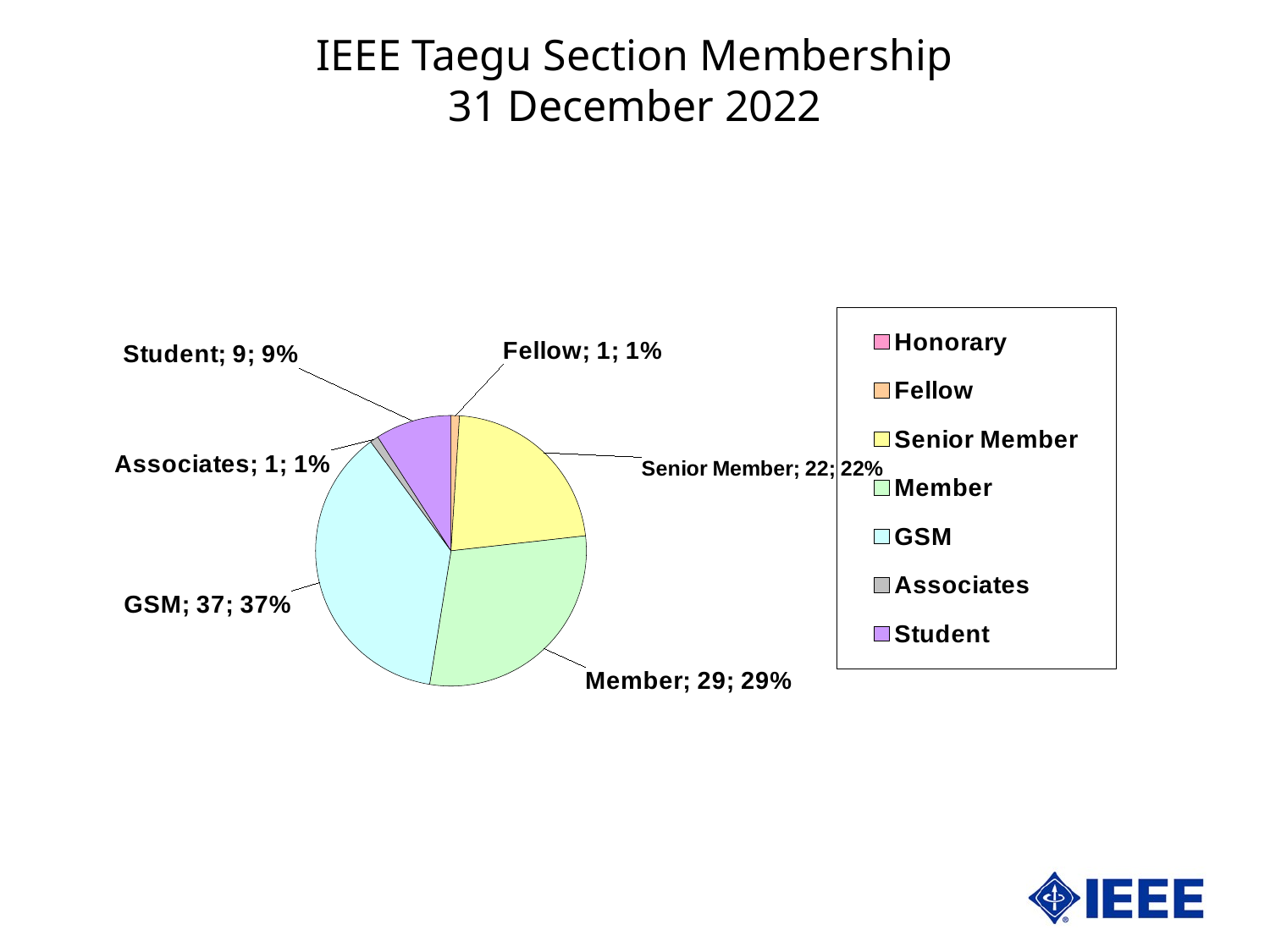
What is the difference between the GSM count and the Member count? 8 Which category has the largest slice of the pie? GSM Which is larger, the Member slice or the Senior Member slice? Member What colour is the GSM slice in the pie chart? light cyan How many members are in the GSM category? 37 What type of chart is shown on the slide? pie chart What percentage of membership is Student? 9% How many Senior Members are shown? 22 How many entries does the legend list? 7 What share of the pie does the Member category represent? 29% What is the title of the slide containing the chart? IEEE Taegu Section Membership 31 December 2022 How many Fellows are shown in the chart? 1